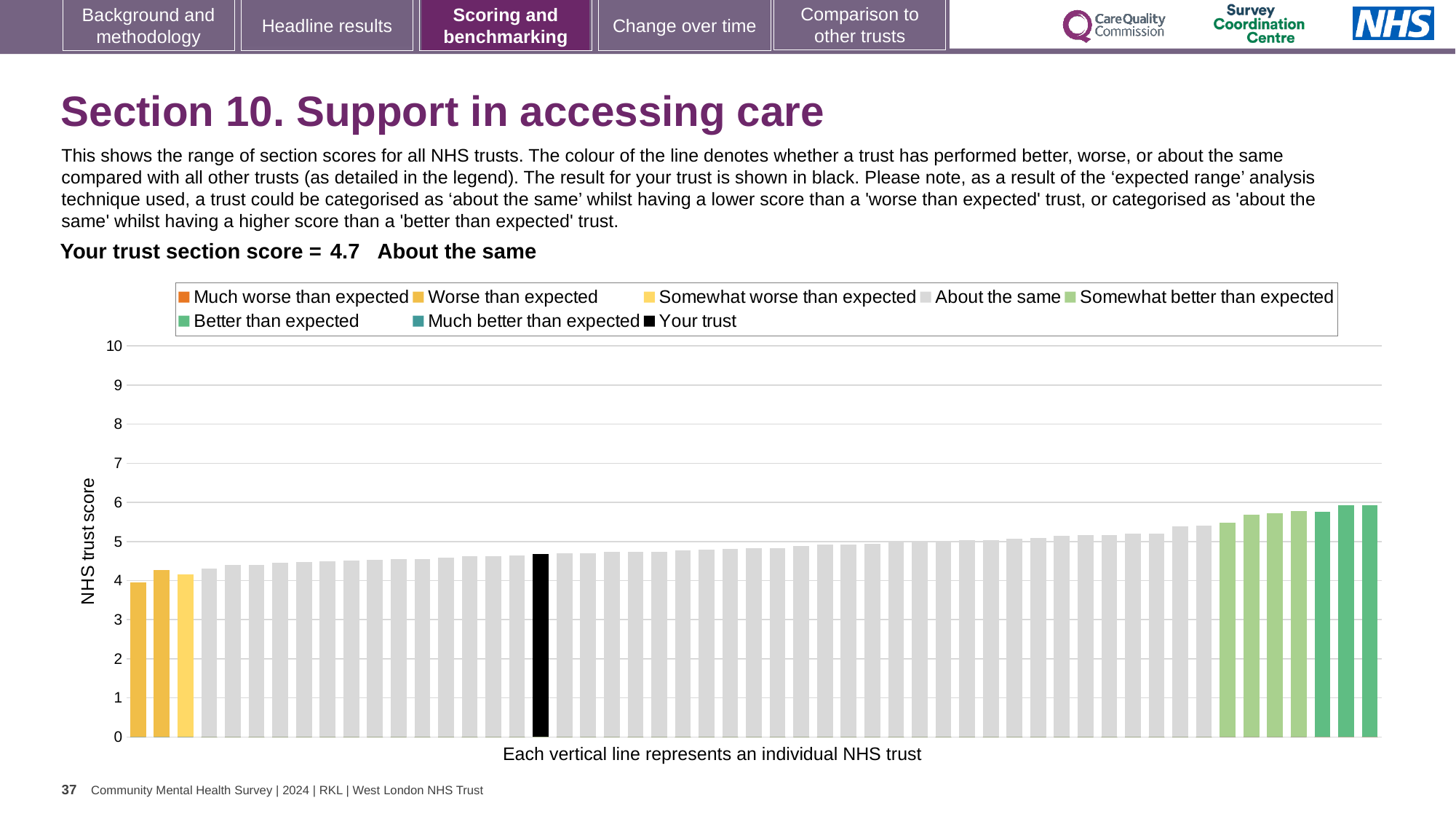
Which benchmarking category is your trust placed in for this section? About the same Is the value of the shortest bar in the chart greater or less than 3? greater What kind of chart is shown on the slide? bar chart Is the value for your trust (the black bar) greater or less than 5? less What is the section score for your trust shown on the slide? 4.7 How many entries does the chart legend list? 8 Do the bar values rise or fall from left to right along the x axis? rise Is the value for your trust (the black bar) greater or less than 4? greater What is the label on the vertical axis of the chart? NHS trust score